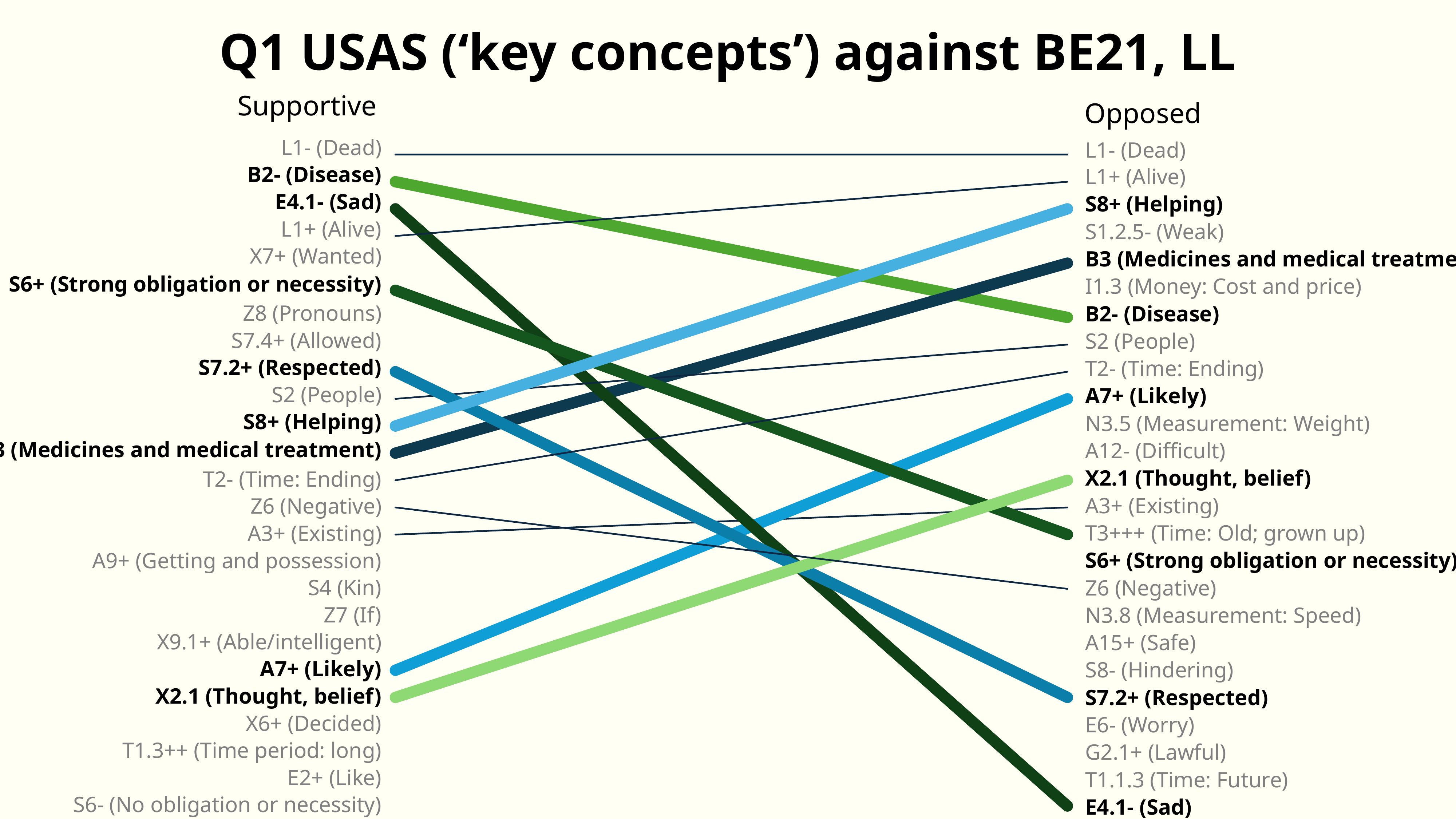
Does E4.1- (Sad) move up or down in rank from the Supportive list to the Opposed list? Down What is the title of the chart? Q1 USAS ('key concepts') against BE21, LL What rank does E4.1- (Sad) hold in the Supportive list? 3rd What kind of chart is shown on the slide? Slope chart Does S8+ (Helping) move up or down in rank from the Supportive list to the Opposed list? Up In the Opposed list, which is ranked higher: S8+ (Helping) or S7.2+ (Respected)? S8+ (Helping) Which key concept is ranked at the bottom of the Supportive list? S6- (No obligation or necessity) Which key concept is ranked at the bottom of the Opposed list? E4.1- (Sad) Which key concept is ranked at the top of the Opposed list? L1- (Dead) What rank does B2- (Disease) hold in the Opposed list? 7th How many key concepts are listed in the Supportive column? 25 Which key concept is ranked at the top of the Supportive list? L1- (Dead)